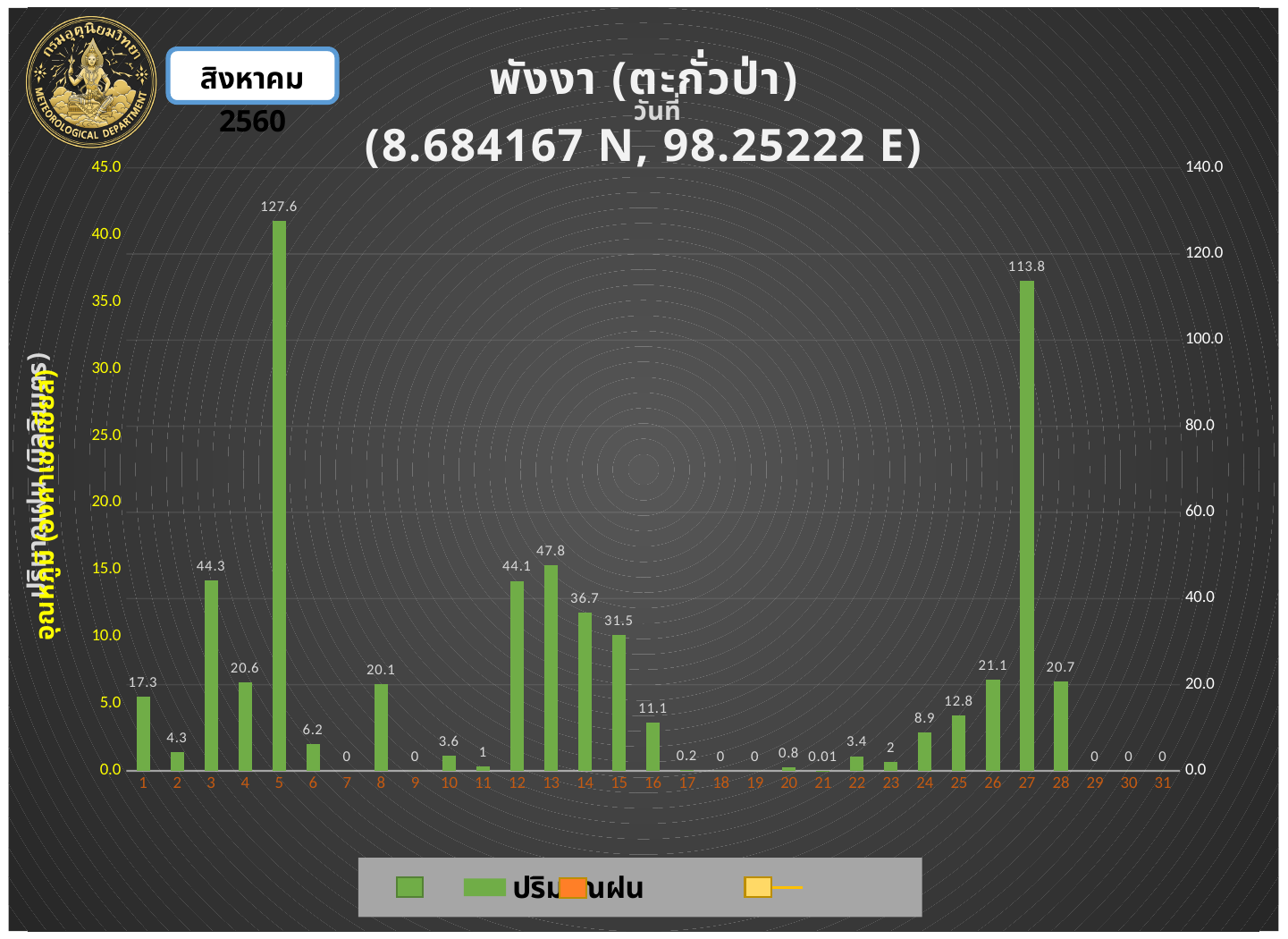
What is the value labelled for day 21? 0.01 Which day has the highest rainfall value? 5 What is the difference between the values for day 3 and day 4? 23.7 What is the difference between the values for day 5 and day 27? 13.8 Which has the larger value, day 12 or day 14? day 12 What is the value labelled for day 13? 47.8 What is the rainfall value shown for day 27? 113.8 What is the highest tick value on the right-hand vertical axis? 140.0 What are the coordinates given in the chart title? 8.684167 N, 98.25222 E How many days (categories) are shown on the x axis? 31 What kind of chart is shown on the slide? bar chart What is the rainfall value shown for day 5? 127.6